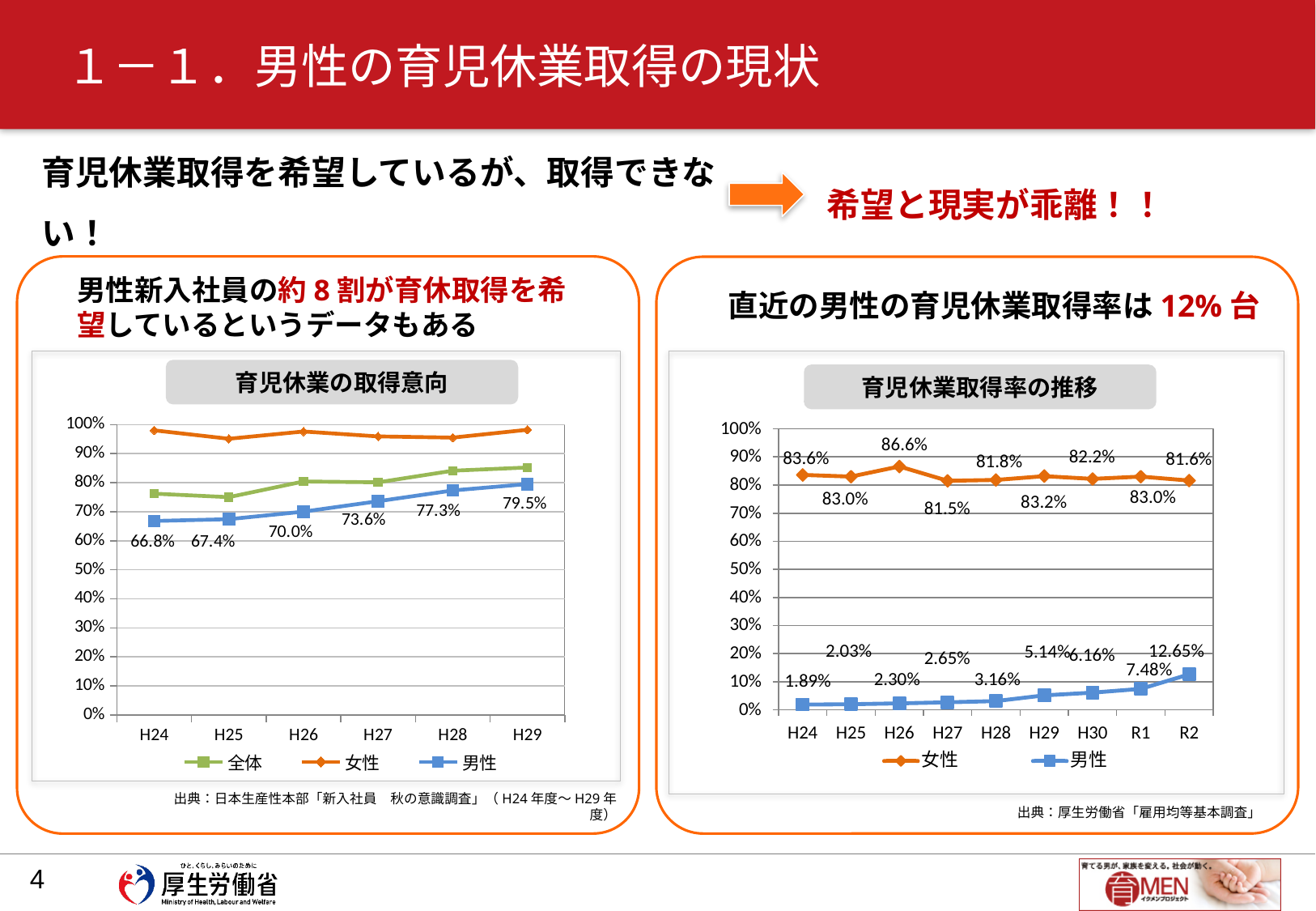
In the chart titled 育児休業の取得意向, how many series does the legend list? 3 In the chart titled 育児休業取得率の推移, what is the value for 男性 in R2? 12.65% In the chart titled 育児休業取得率の推移, what is the value for 女性 in H26? 86.6% In the chart titled 育児休業の取得意向, how much did the 男性 value increase from H24 to H29? 12.7 percentage points In the chart titled 育児休業取得率の推移, how many years are shown on the x axis? 9 In the chart titled 育児休業の取得意向, what is the value for 男性 in H29? 79.5% In the chart titled 育児休業の取得意向, is the value for 女性 in H26 greater or less than 90%? greater What kind of chart is the chart titled 育児休業取得率の推移? line chart In the chart titled 育児休業の取得意向, does the 男性 line rise or fall from H24 to H29? rise In the chart titled 育児休業取得率の推移, in which year is the 女性 value highest? H26 In the chart titled 育児休業取得率の推移, in which year is the 男性 value lowest? H24 In the chart titled 育児休業の取得意向, what is the value for 男性 in H24? 66.8%